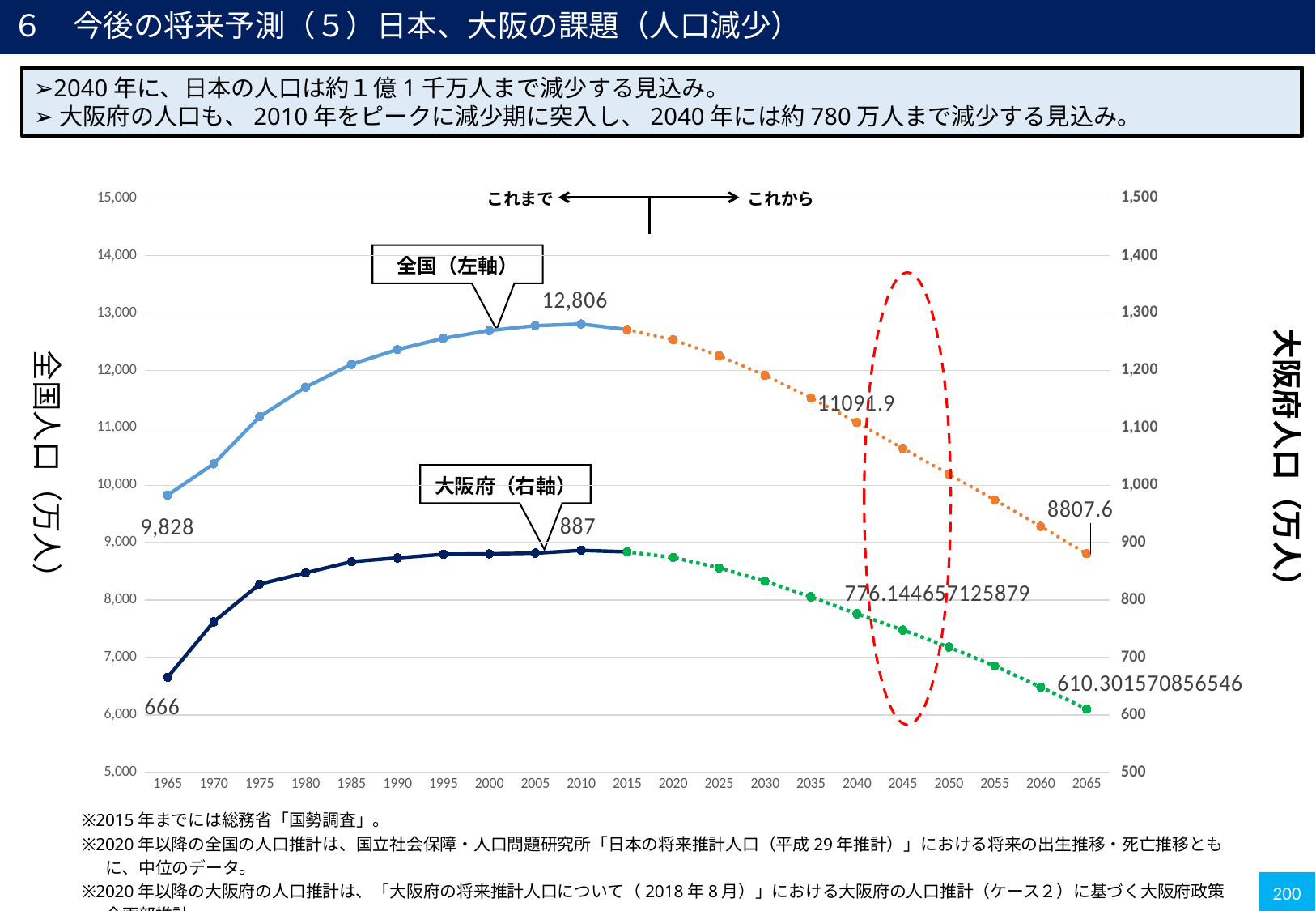
What is the value of the 全国 (national population) series in 2010? 12,806 In which year does the 全国 series reach its highest value? 2010 What type of chart is shown on the slide? line chart What is the value of the 全国 series in 2040? 11091.9 Does the 全国 series rise or fall between 2015 and 2065? fall How many years are shown on the x axis? 21 What is the value of the 大阪府 series in 2010? 887 What is the value of the 全国 series in 2065? 8807.6 What is the value of the 大阪府 series in 2065? 610.301570856546 What is the value of the 全国 series in 1965? 9,828 Is the value of the 大阪府 series in 2050 greater or less than 700? greater What is the value of the 大阪府 (Osaka) series in 1965? 666